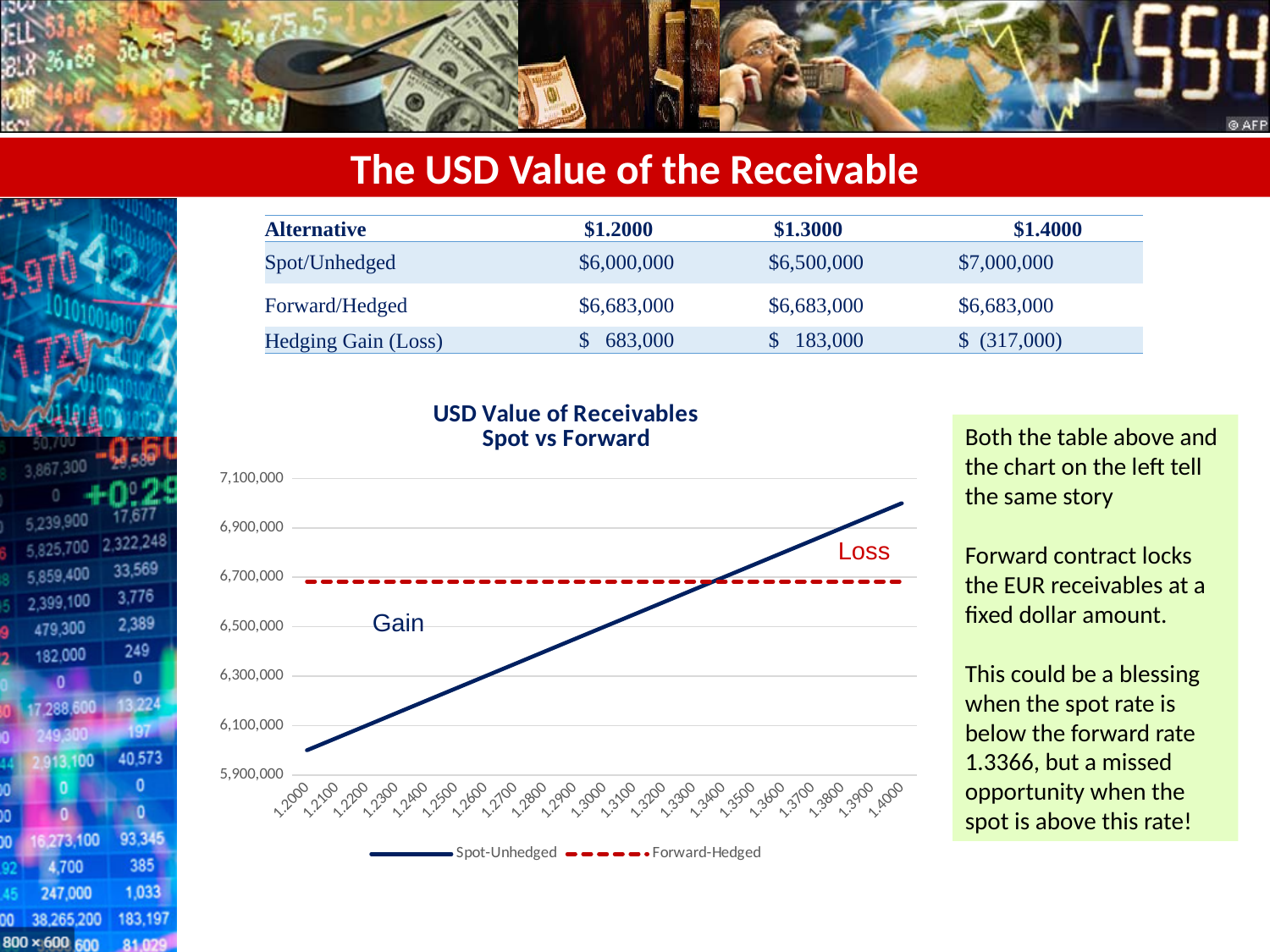
What is the title of the chart? USD Value of Receivables Spot vs Forward Is the Spot-Unhedged value at 1.2000 greater or less than 6,100,000? less Does the Forward-Hedged line rise, fall, or stay flat across the x axis? stay flat Is the Forward-Hedged value greater or less than 6,500,000? greater How many series does the chart legend list? 2 Does the Spot-Unhedged line rise or fall as the exchange rate increases along the x axis? rise What kind of chart is shown on the slide? line chart At an exchange rate of 1.2000, which series has the higher value, Spot-Unhedged or Forward-Hedged? Forward-Hedged Which series is drawn as a dashed line in the chart? Forward-Hedged How many exchange-rate points are plotted along the x axis of the chart? 21 Is the Spot-Unhedged value at 1.4000 greater or less than 6,900,000? greater At an exchange rate of 1.4000, which series has the higher value, Spot-Unhedged or Forward-Hedged? Spot-Unhedged